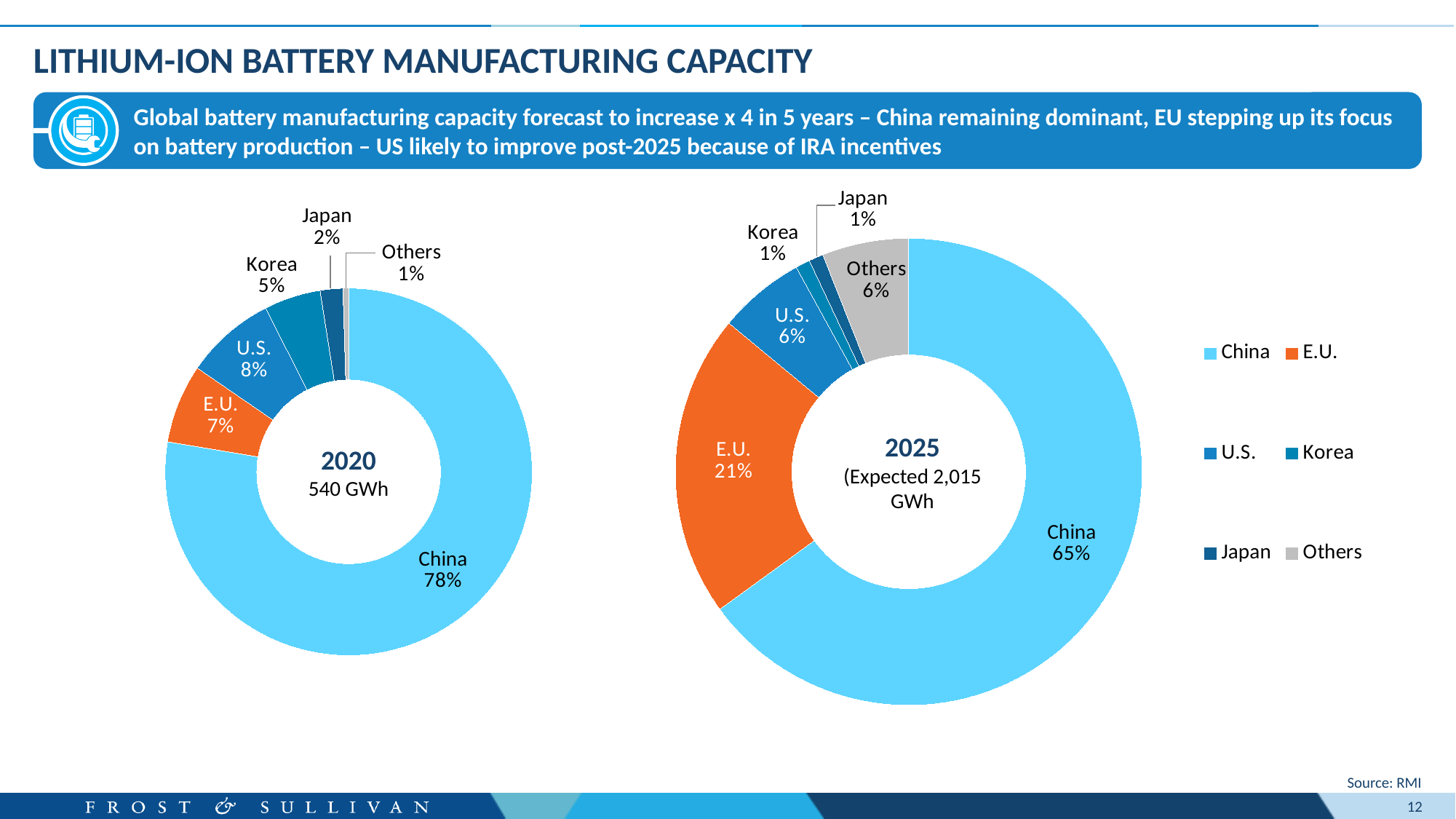
In the 2020 chart, which region has the smallest share? Others In the 2025 chart, what share does Others hold? 6% In the 2025 chart, which region has the largest share? China What kind of chart is used on this slide? Doughnut chart What total capacity is shown in the centre of the 2020 chart? 540 GWh In the 2020 chart, what share does the U.S. hold? 8% How many regions are shown in the 2025 chart? 6 In the 2020 chart, which region has the largest share? China In the 2020 chart, what share does China hold? 78% In the 2025 chart, which is larger, the share of the E.U. or the share of the U.S.? E.U. In the 2025 chart, what share does the E.U. hold? 21% What is the difference between China's share in 2020 and in 2025? 13 percentage points